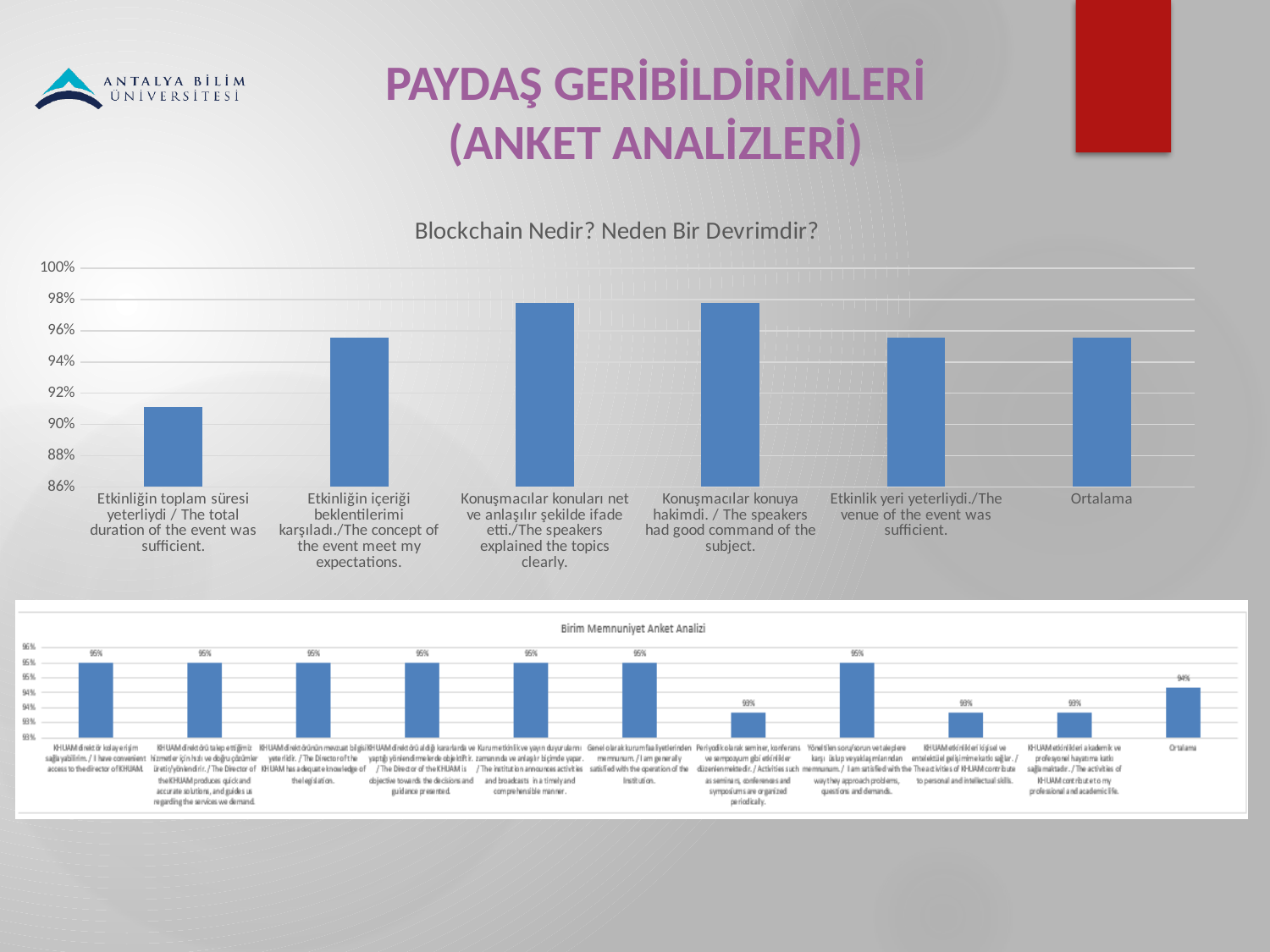
In the bottom chart "Birim Memnuniyet Anket Analizi", what is the value for "Ortalama"? 94% In the top chart "Blockchain Nedir? Neden Bir Devrimdir?", is the value for "Ortalama" greater or less than 94%? greater In the top chart "Blockchain Nedir? Neden Bir Devrimdir?", is the value for "Konuşmacılar konuları net ve anlaşılır şekilde ifade etti./The speakers explained the topics clearly." greater or less than 96%? greater What is the title of the top chart on the slide? Blockchain Nedir? Neden Bir Devrimdir? In the bottom chart "Birim Memnuniyet Anket Analizi", how many bars are plotted? 11 What type of chart is the top chart titled "Blockchain Nedir? Neden Bir Devrimdir?"? bar chart In the top chart "Blockchain Nedir? Neden Bir Devrimdir?", which is larger: the value for "Konuşmacılar konuya hakimdi. / The speakers had good command of the subject." or the value for "Etkinlik yeri yeterliydi./The venue of the event was sufficient."? Konuşmacılar konuya hakimdi. / The speakers had good command of the subject. What is the title of the bottom chart on the slide? Birim Memnuniyet Anket Analizi In the top chart "Blockchain Nedir? Neden Bir Devrimdir?", which category has the lowest value? Etkinliğin toplam süresi yeterliydi / The total duration of the event was sufficient. What type of chart is the bottom chart titled "Birim Memnuniyet Anket Analizi"? bar chart In the top chart "Blockchain Nedir? Neden Bir Devrimdir?", how many categories are plotted? 6 In the top chart "Blockchain Nedir? Neden Bir Devrimdir?", is the value for "Etkinliğin toplam süresi yeterliydi / The total duration of the event was sufficient." greater or less than 92%? less